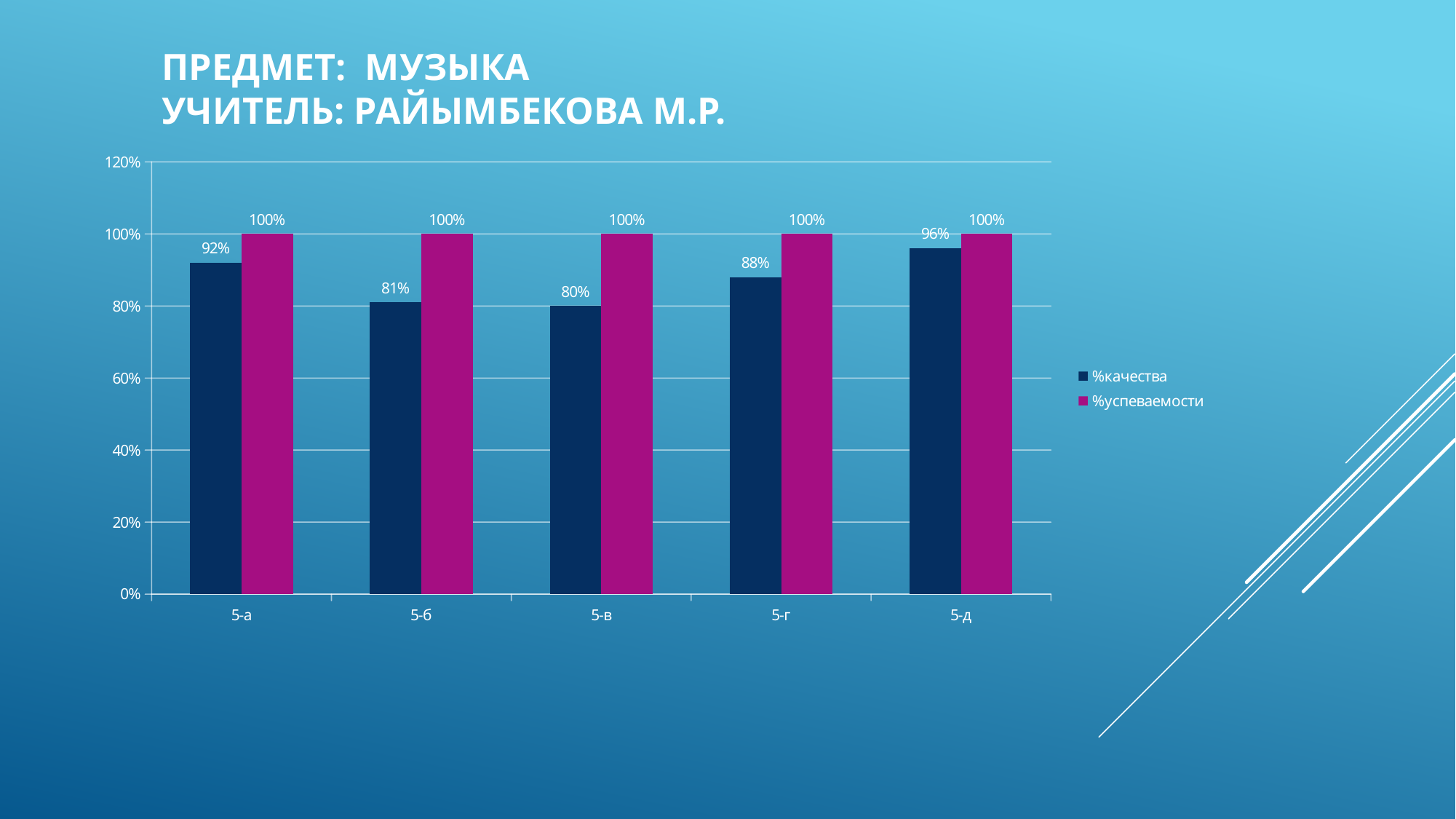
Which class has the highest %качества value? 5-д How many classes are shown on the x axis? 5 What kind of chart is shown on the slide? bar chart Is the %качества value for 5-б greater or less than 100%? less What is the %качества value for 5-в? 80% Which class has the lowest %качества value? 5-в What is the %успеваемости value for 5-г? 100% What colour are the %успеваемости bars? magenta Which is larger, the %качества value for 5-а or for 5-г? 5-а How many series does the legend list? 2 What is the %качества value for 5-а? 92% What is the difference between the %качества values for 5-д and 5-б? 15%